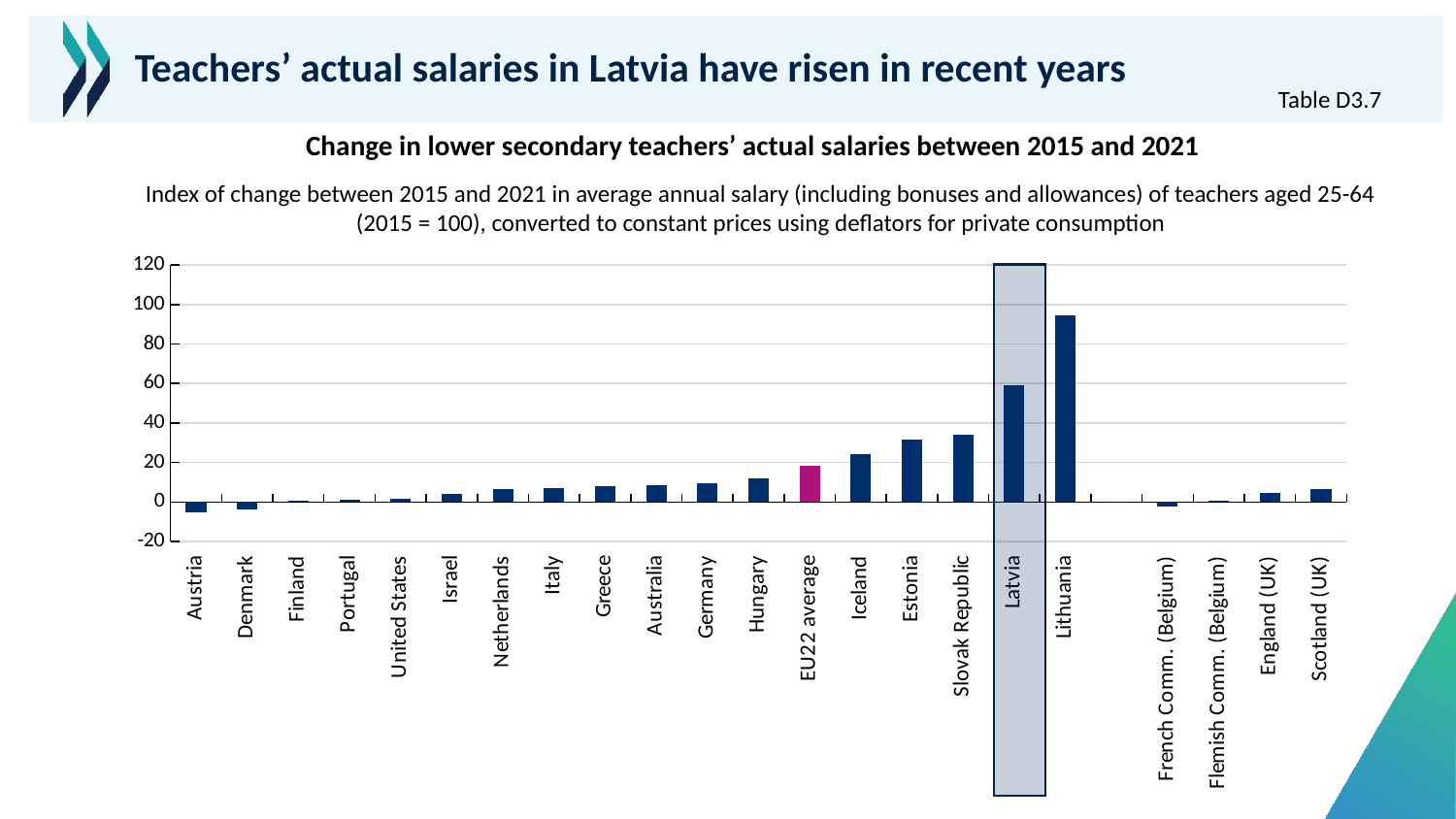
Is the value for the Slovak Republic greater or less than 20? greater Is the value for Austria greater or less than 0? less How many countries or entities are shown on the x axis of the chart? 22 What kind of chart is shown on the slide? bar chart Which bar is shown in a different colour (magenta) from the other bars? EU22 average Do the values generally rise or fall moving along the x axis from Austria to Lithuania? rise Is the value for Lithuania greater or less than 80? greater Which has a larger value, Latvia or Lithuania? Lithuania Which country has the highest index of change in teachers' actual salaries? Lithuania Which has a larger value, Iceland or Hungary? Iceland